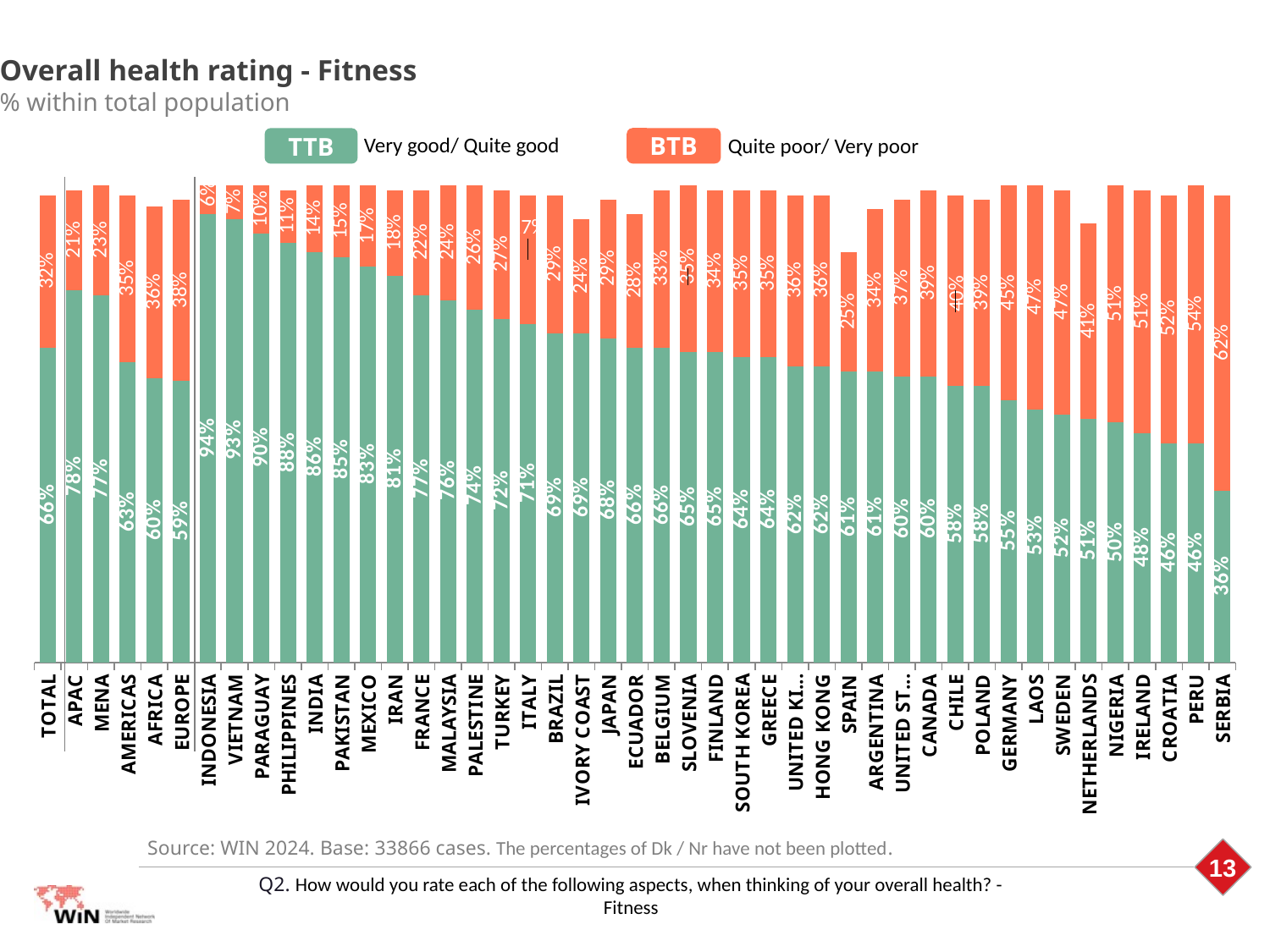
Which category has the lowest TTB (Very good/ Quite good) value? Serbia What is the TTB value for TOTAL? 66% Which category has the highest TTB (Very good/ Quite good) value? Indonesia What is the BTB (Quite poor/ Very poor) value for Serbia? 62% Which has a larger BTB value, Germany or Japan? Germany What is the difference between the TTB values for Vietnam and Peru? 47% Which colour represents the BTB (Quite poor/ Very poor) series? Orange What kind of chart is shown on the slide? Stacked bar chart What is the total of the TTB and BTB segments for Nigeria? 101% What is the TTB (Very good/ Quite good) value for Indonesia? 94% How many series does the legend list? 2 What is the BTB value for Europe? 38%